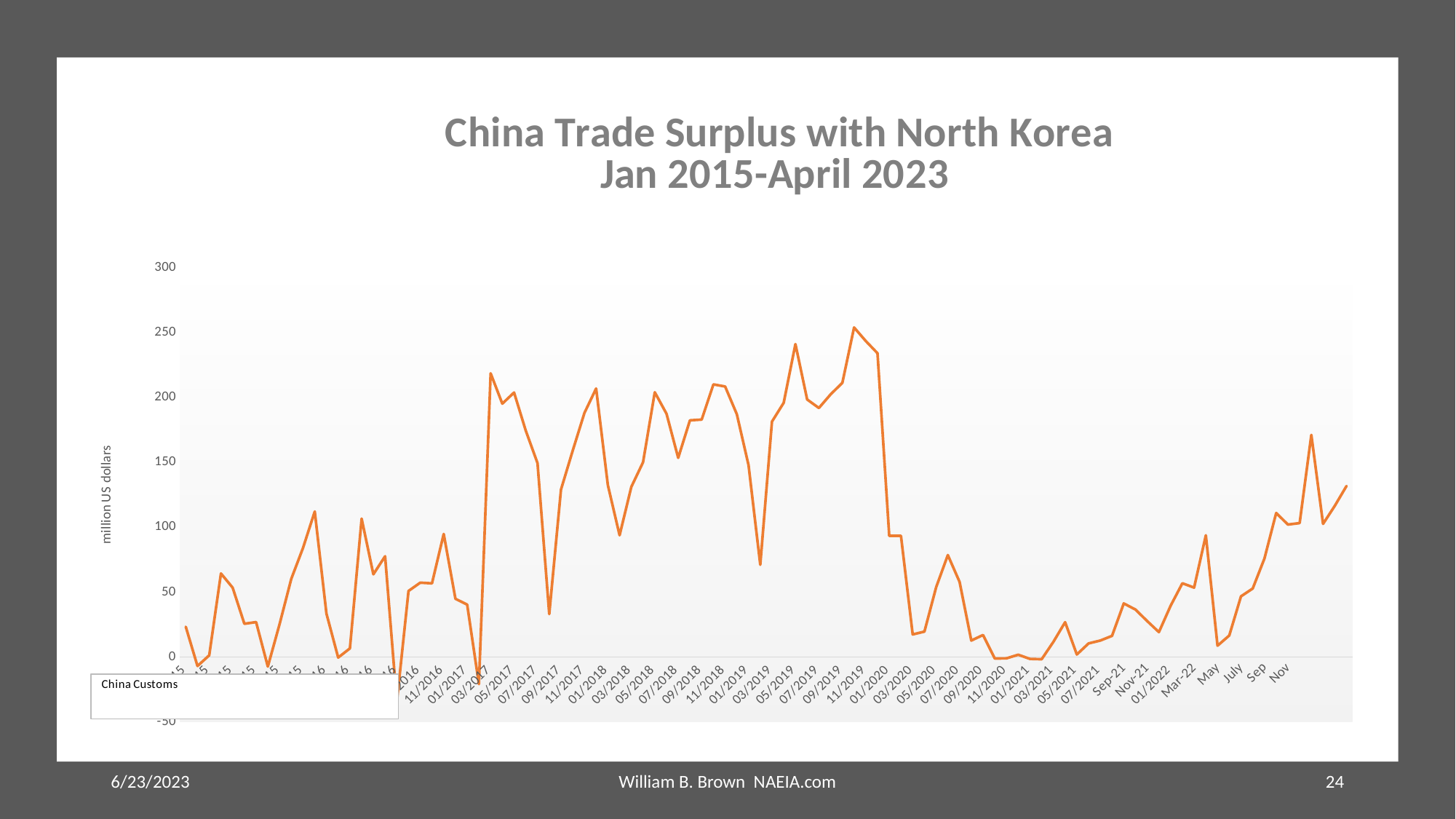
How many lines (data series) are plotted on the chart? 1 Does the line generally rise or fall between 05/2021 and Nov (2022)? rise Is the value for 09/2017 greater or less than 50? greater Is the value for 01/2021 greater or less than 50? less Is the value for 05/2019 greater or less than 200? greater What kind of chart is shown on the slide? line chart Does the line rise or fall between 11/2019 and 03/2020? fall What is the label on the vertical axis of the chart? million US dollars What is the title of the chart? China Trade Surplus with North Korea Jan 2015-April 2023 Which is larger, the value for 11/2019 or the value for 03/2020? 11/2019